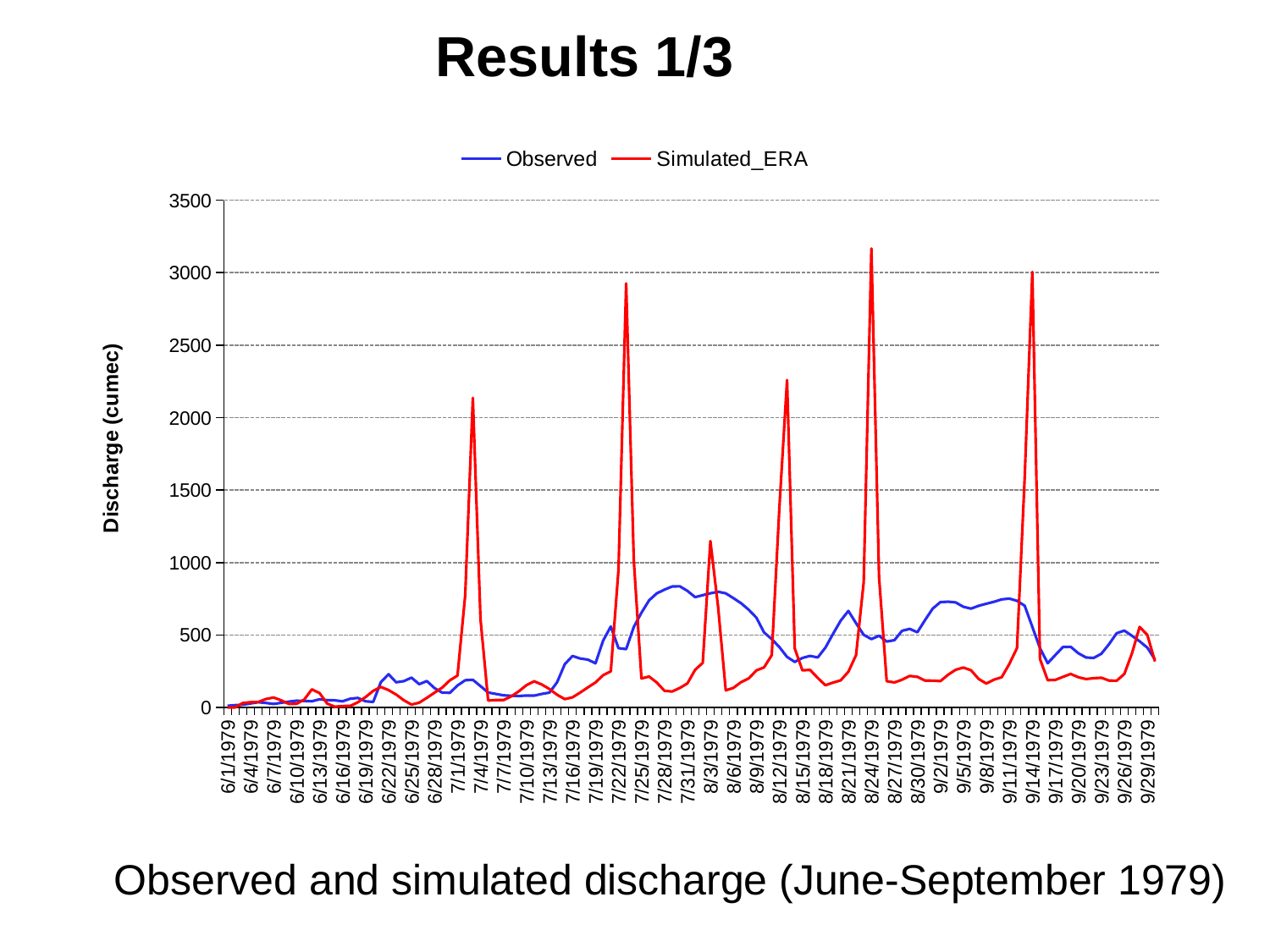
Is the peak value of Simulated_ERA around 8/24/1979 greater or less than 3000? greater Is the peak value of Simulated_ERA around 8/12/1979 greater or less than 2000? greater At 9/8/1979, which series has the larger value, Observed or Simulated_ERA? Observed Which series reaches the highest value on the chart? Simulated_ERA Is the highest value of the Observed series greater or less than 1000? less At 8/24/1979, which series has the larger value, Observed or Simulated_ERA? Simulated_ERA How many series does the legend list? 2 What kind of chart is shown on the slide? line chart Does the Observed series generally rise or fall from 6/1/1979 to 7/28/1979? rise What are the two series named in the legend? Observed and Simulated_ERA What is the label on the vertical axis? Discharge (cumec)